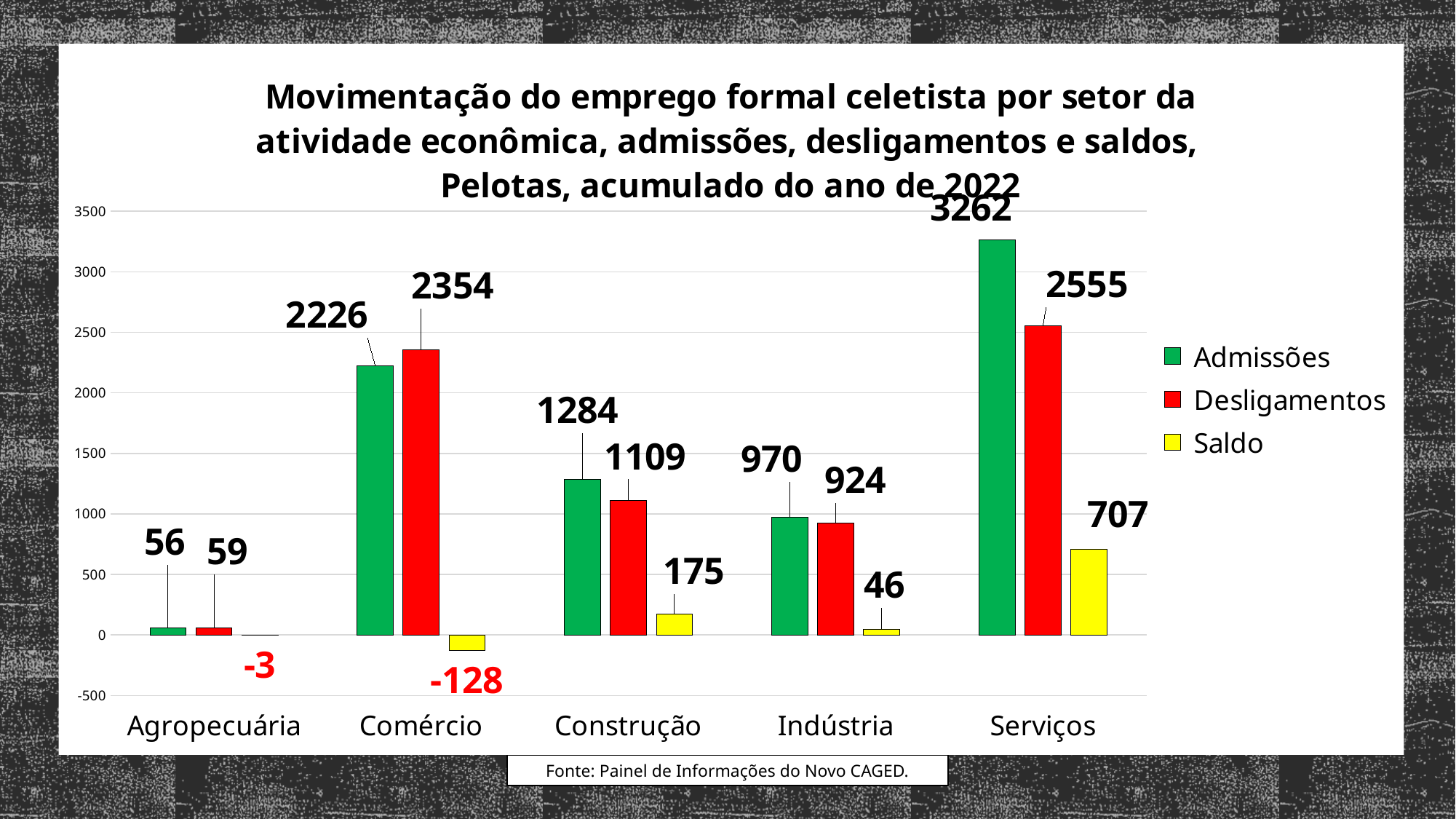
What is the Desligamentos value for Serviços? 2555 What is the Saldo value for Comércio? -128 Is the Admissões value for Serviços greater or less than 3000? greater How many series does the legend list? 3 Which sector has the highest Admissões value? Serviços Which sector has the lowest Saldo value? Comércio What kind of chart is shown on the slide? Bar chart What is the Saldo value for Indústria? 46 What is the difference between Admissões and Desligamentos for Construção? 175 How many sectors are shown on the x axis? 5 What is the Admissões value for Comércio? 2226 Which is larger for Comércio, Admissões or Desligamentos? Desligamentos